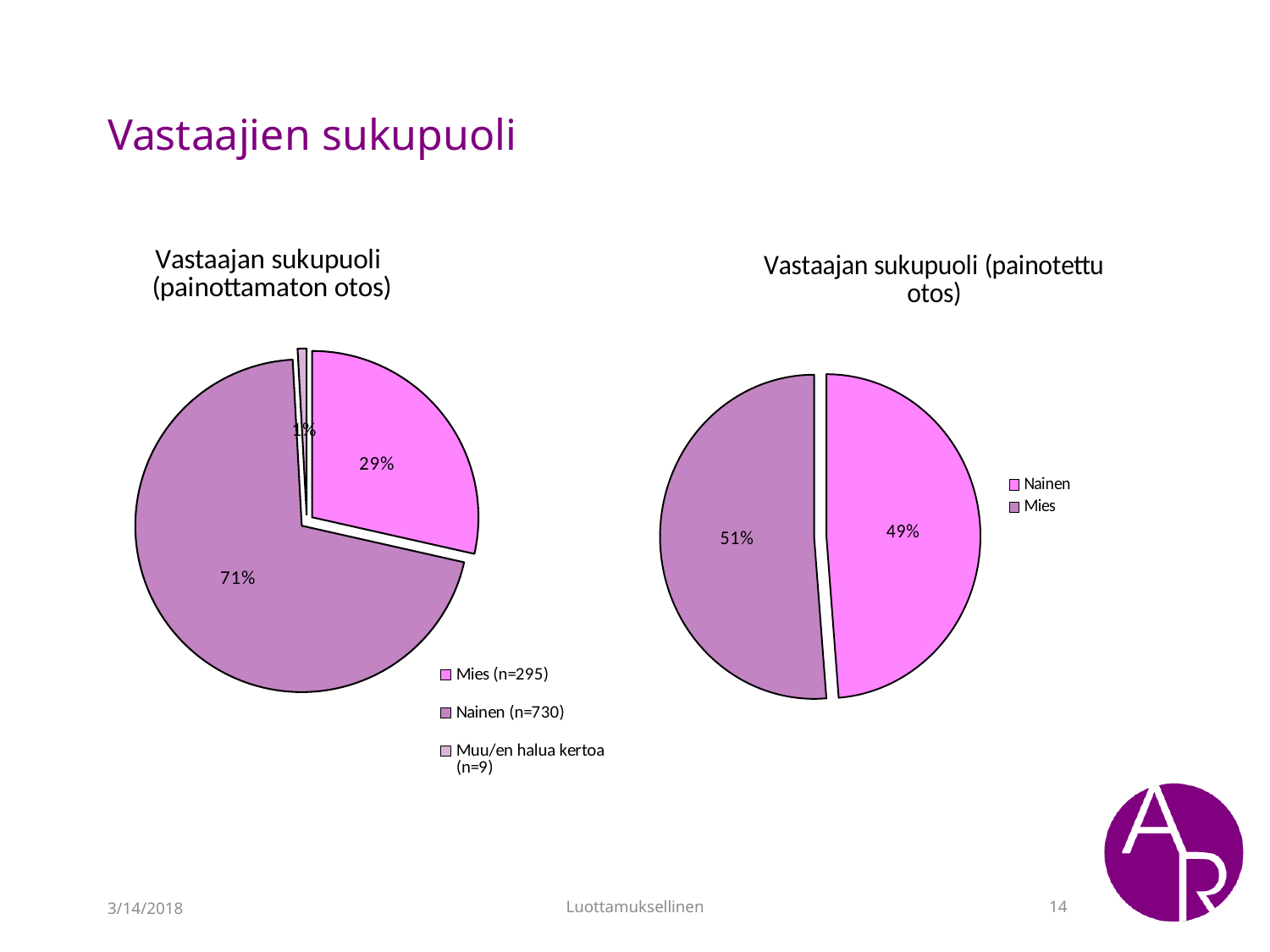
How many categories does the legend of the left chart (painottamaton otos) list? 3 In the left chart (painottamaton otos), what is the difference in percentage points between Nainen and Mies? 42 What type of chart is used on this slide? Pie chart In the left chart (painottamaton otos), which category has the smallest slice? Muu/en halua kertoa (n=9) In the left chart (painottamaton otos), what share of respondents is Nainen (n=730)? 71% In the left chart (painottamaton otos), what share is Muu/en halua kertoa (n=9)? 1% In the left chart (painottamaton otos), what share of respondents is Mies (n=295)? 29% In the right chart (painotettu otos), what share of respondents is Nainen? 49% In the left chart (painottamaton otos), which category has the largest slice? Nainen (n=730) In the right chart (painotettu otos), which is larger, Nainen or Mies? Mies What is the title of the right chart? Vastaajan sukupuoli (painotettu otos) In the right chart (painotettu otos), what share of respondents is Mies? 51%